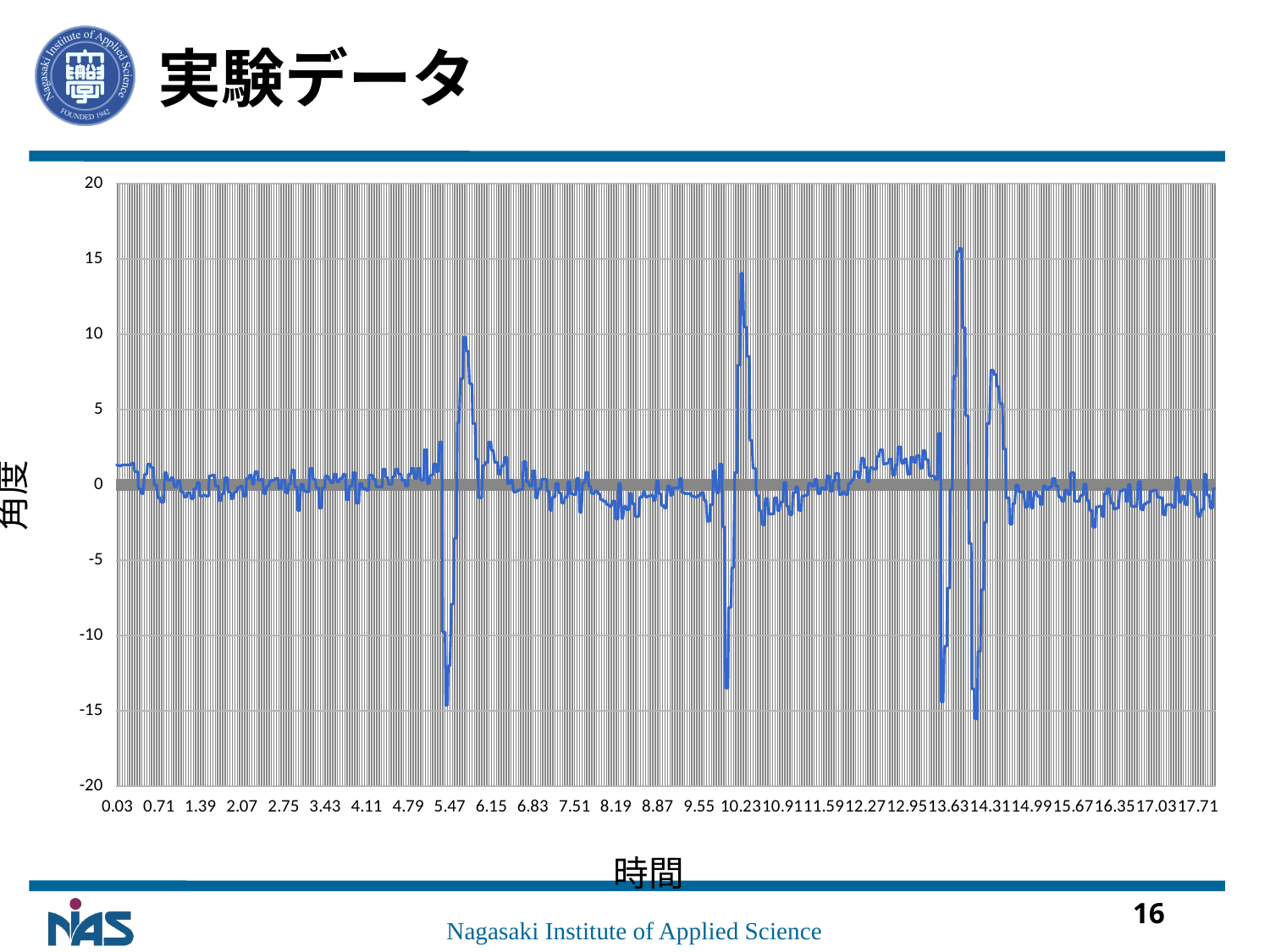
Is the value of the line at x = 0.03 greater or less than 5? less Is the highest value reached by the line greater or less than 10? greater What is the label of the y axis of the chart? 角度 How many data series are plotted in the chart? 1 Is the lowest value reached by the line greater or less than -10? less What is the label of the x axis of the chart? 時間 What kind of chart is shown on the slide? line chart Does the line show a steady rise, a steady fall, or fluctuation around zero with spikes along the x axis? fluctuation around zero with spikes